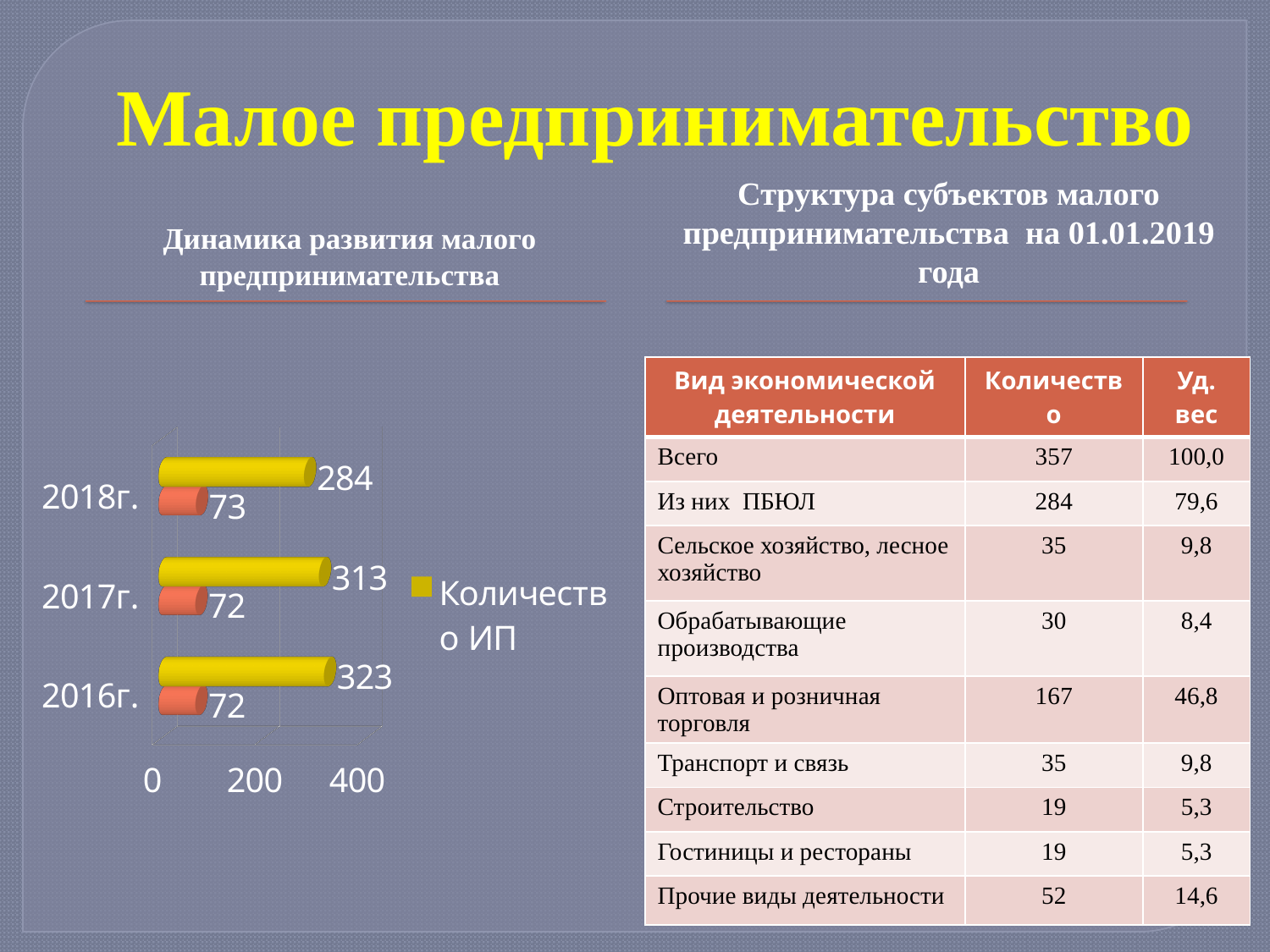
Is the value of Количество ИП for 2018г. greater or less than 200? greater What is the value of Количество ИП for 2016г.? 323 What is the difference between Количество ИП in 2016г. and 2018г.? 39 How many years are shown on the chart? 3 Which is larger, Количество ИП in 2017г. or in 2018г.? 2017г. Which year has the lowest value of Количество ИП? 2018г. What is the value of the red bar for 2018г.? 73 Does Количество ИП rise or fall from 2016г. to 2018г.? fall Which year has the highest value of Количество ИП? 2016г. What is the value of Количество ИП for 2018г.? 284 What is the value of Количество ИП for 2017г.? 313 What kind of chart is shown on the slide? bar chart